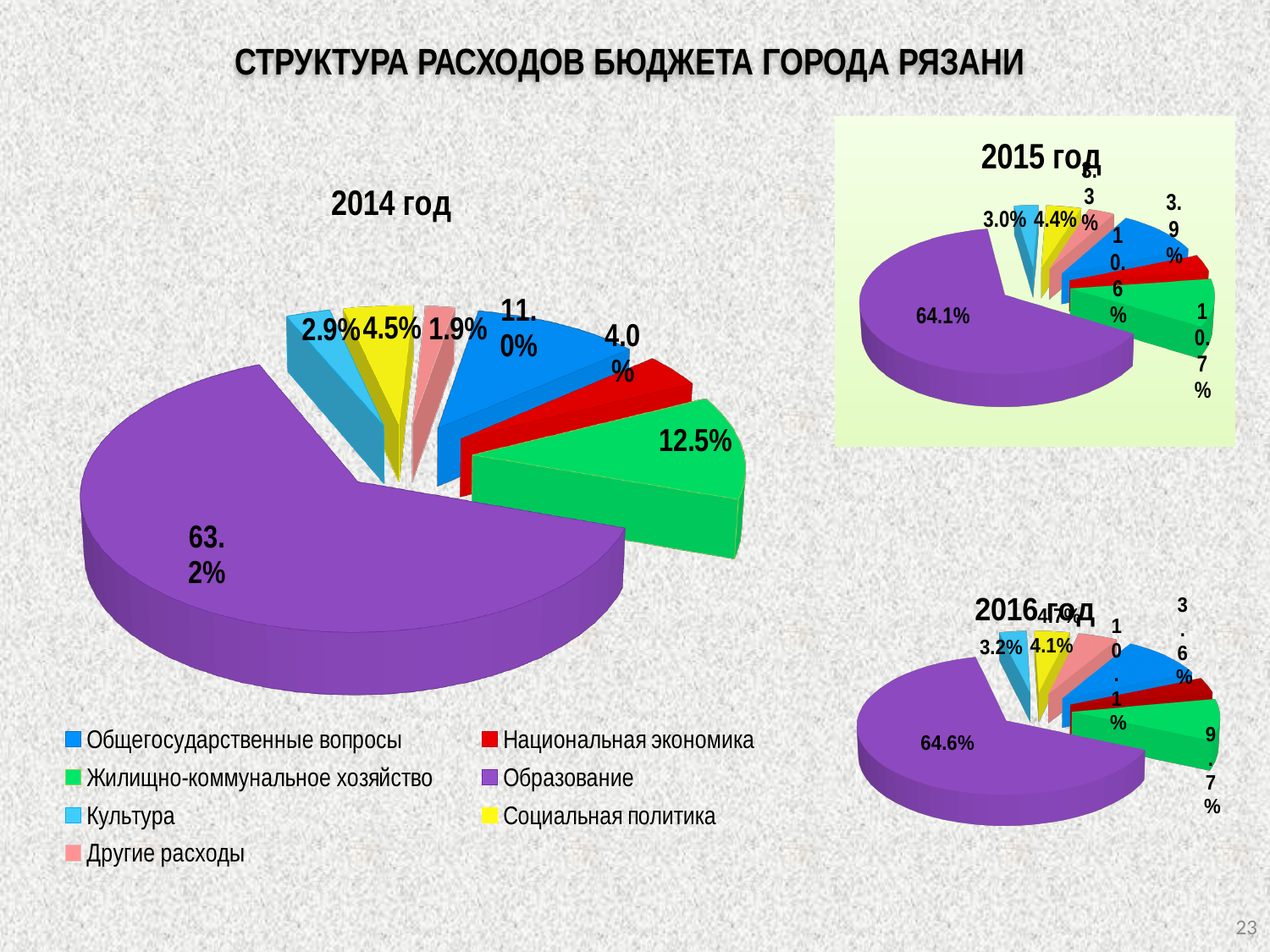
In the 2014 год chart, what is the difference between the shares of Жилищно-коммунальное хозяйство and Общегосударственные вопросы? 1.5% How many categories does the legend list? 7 In the 2016 год chart, what share does Образование have? 64.6% In the 2015 год chart, what share does Культура have? 3.0% In the 2014 год chart, which category has the smallest share? Другие расходы In the 2016 год chart, which is larger: the share of Жилищно-коммунальное хозяйство or the share of Социальная политика? Жилищно-коммунальное хозяйство In the 2014 год chart, what share does Жилищно-коммунальное хозяйство have? 12.5% In the 2014 год chart, what share does Образование have? 63.2% In the 2015 год chart, what share does Образование have? 64.1% In the 2014 год chart, what share does Общегосударственные вопросы have? 11.0% What type of chart is used for the 2014 год chart? pie chart In the 2014 год chart, which category has the largest share? Образование